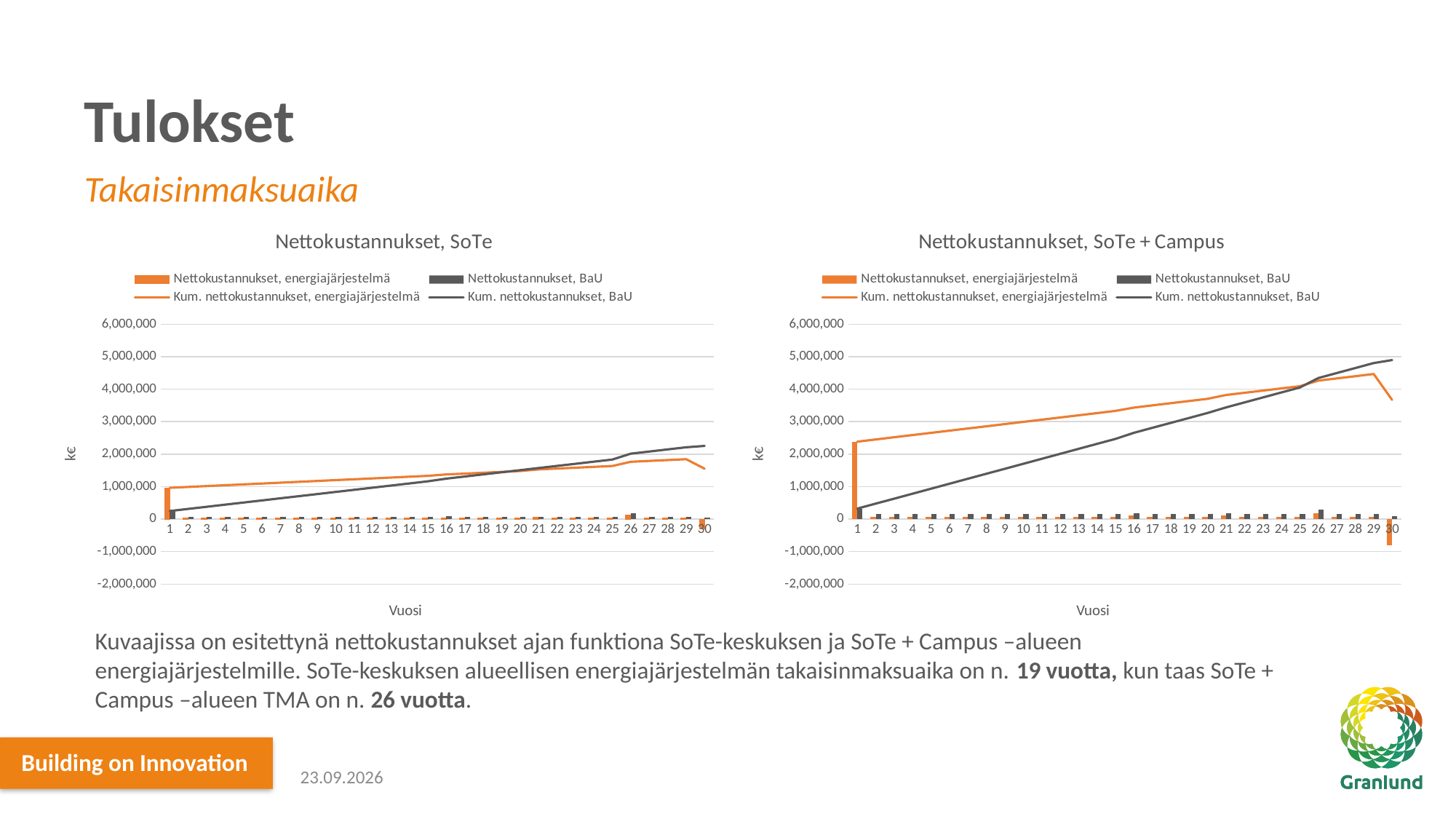
How many years are shown on the x axis of the "Nettokustannukset, SoTe" chart? 30 In the "Nettokustannukset, SoTe + Campus" chart, is the value of "Kum. nettokustannukset, energiajärjestelmä" at year 1 greater or less than 2,000,000? greater What kind of chart is "Nettokustannukset, SoTe"? A combined bar and line chart In the "Nettokustannukset, SoTe + Campus" chart, which cumulative line is higher at year 10: "Kum. nettokustannukset, energiajärjestelmä" or "Kum. nettokustannukset, BaU"? Kum. nettokustannukset, energiajärjestelmä How many series does the legend of the "Nettokustannukset, SoTe + Campus" chart list? 4 In the "Nettokustannukset, SoTe" chart, which cumulative line is higher at year 30: "Kum. nettokustannukset, energiajärjestelmä" or "Kum. nettokustannukset, BaU"? Kum. nettokustannukset, BaU What is the y-axis label of the "Nettokustannukset, SoTe" chart? k€ What is the x-axis label of the "Nettokustannukset, SoTe + Campus" chart? Vuosi In the "Nettokustannukset, SoTe + Campus" chart, does the "Kum. nettokustannukset, BaU" line rise or fall from year 1 to year 30? Rise In the "Nettokustannukset, SoTe" chart, is the value of "Kum. nettokustannukset, BaU" at year 30 greater or less than 2,000,000? greater